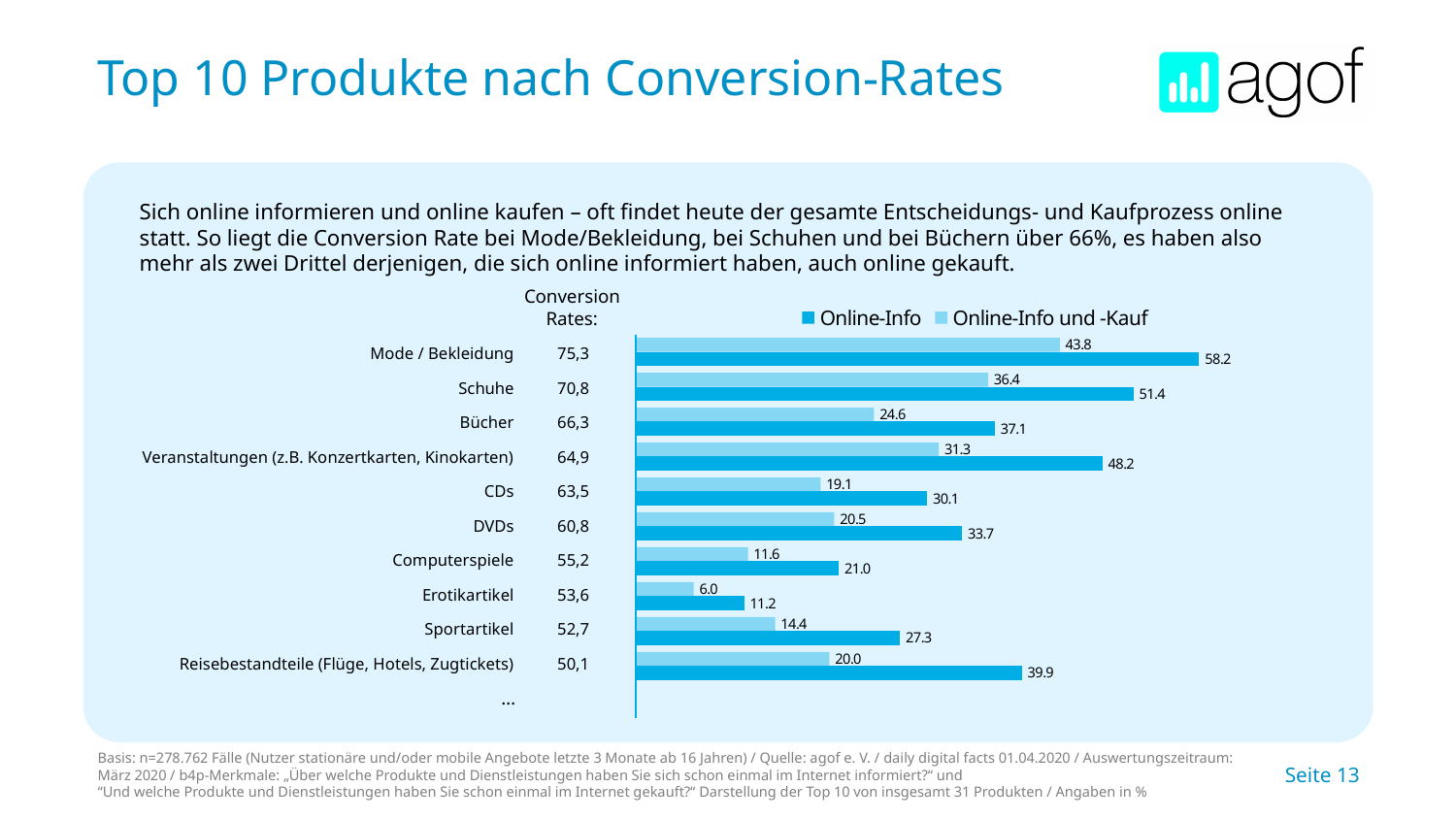
Which is larger: the Online-Info value for DVDs or the Online-Info value for CDs? DVDs Which category has the highest Online-Info value? Mode / Bekleidung What kind of chart is shown on the slide? Bar chart What is the Online-Info und -Kauf value for Veranstaltungen (z.B. Konzertkarten, Kinokarten)? 31.3 How many product categories are plotted in the chart? 10 What is the Online-Info und -Kauf value for Schuhe? 36.4 What is the Online-Info value for Reisebestandteile (Flüge, Hotels, Zugtickets)? 39.9 What is the difference between the Online-Info and Online-Info und -Kauf values for Bücher? 12.5 Which category has the lowest Online-Info und -Kauf value? Erotikartikel What is the Online-Info value for Mode / Bekleidung? 58.2 How many series does the legend list? 2 Which series is shown in the darker blue colour in the legend? Online-Info